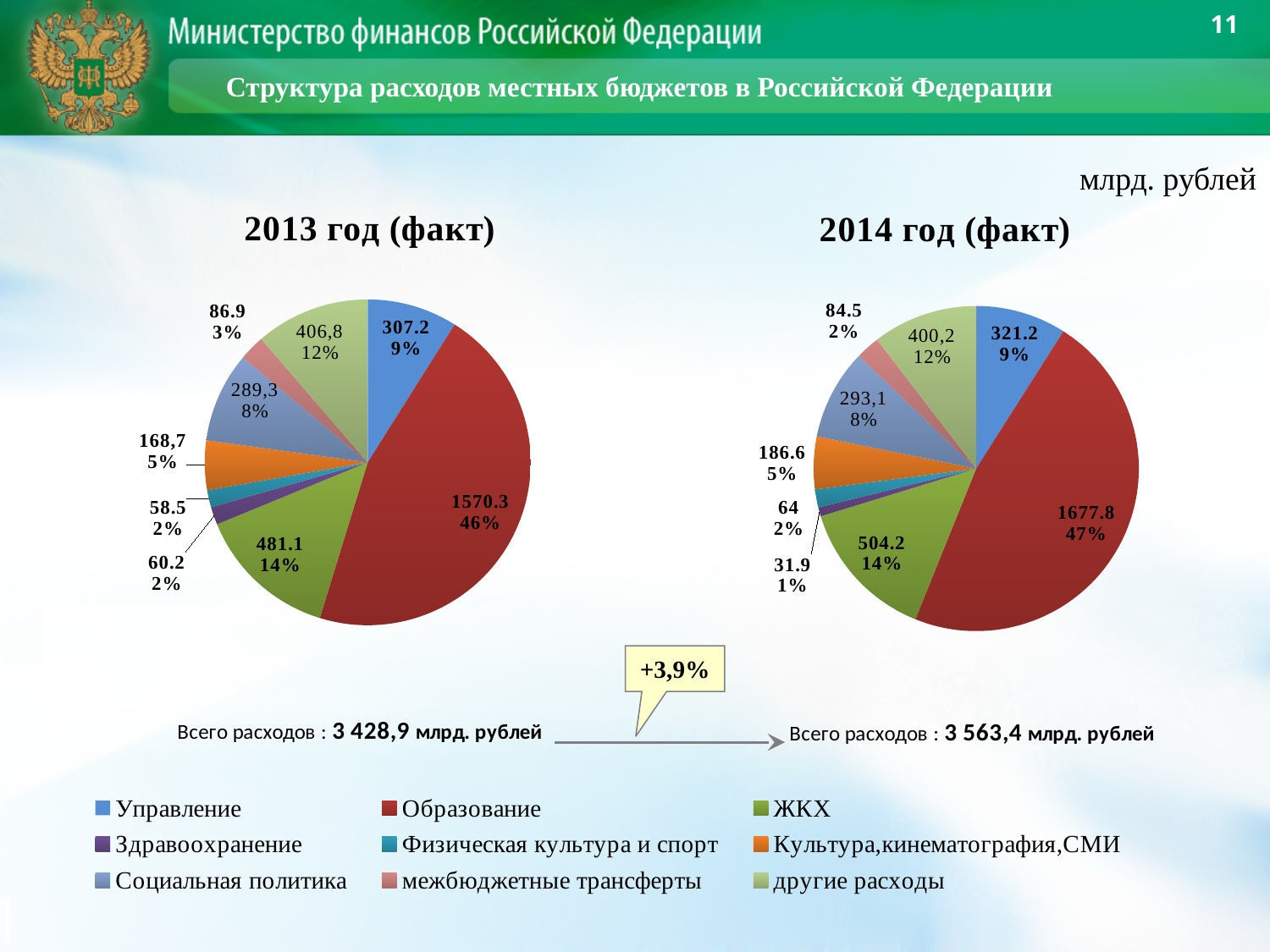
In the 2014 год (факт) chart, what is the value for ЖКХ? 504.2 In the 2014 год (факт) chart, what is the value for межбюджетные трансферты? 84.5 What total expenditure is shown for 2014 below the right chart? 3 563,4 млрд. рублей In the 2013 год (факт) chart, which category has the largest slice? Образование In the 2013 год (факт) chart, what share do другие расходы make up? 12% In the 2014 год (факт) chart, what share of expenditures does Образование account for? 47% By how much did the value for Управление increase from the 2013 chart (307.2) to the 2014 chart (321.2)? 14 In the 2013 год (факт) chart, what is the value for Образование? 1570.3 In the 2013 год (факт) chart, which category has the smallest value? Физическая культура и спорт In the 2013 год (факт) chart, which is larger: Социальная политика or другие расходы? другие расходы What kind of chart is used on this slide for the 2013 and 2014 data? Pie chart How many expenditure categories does the legend list? 9